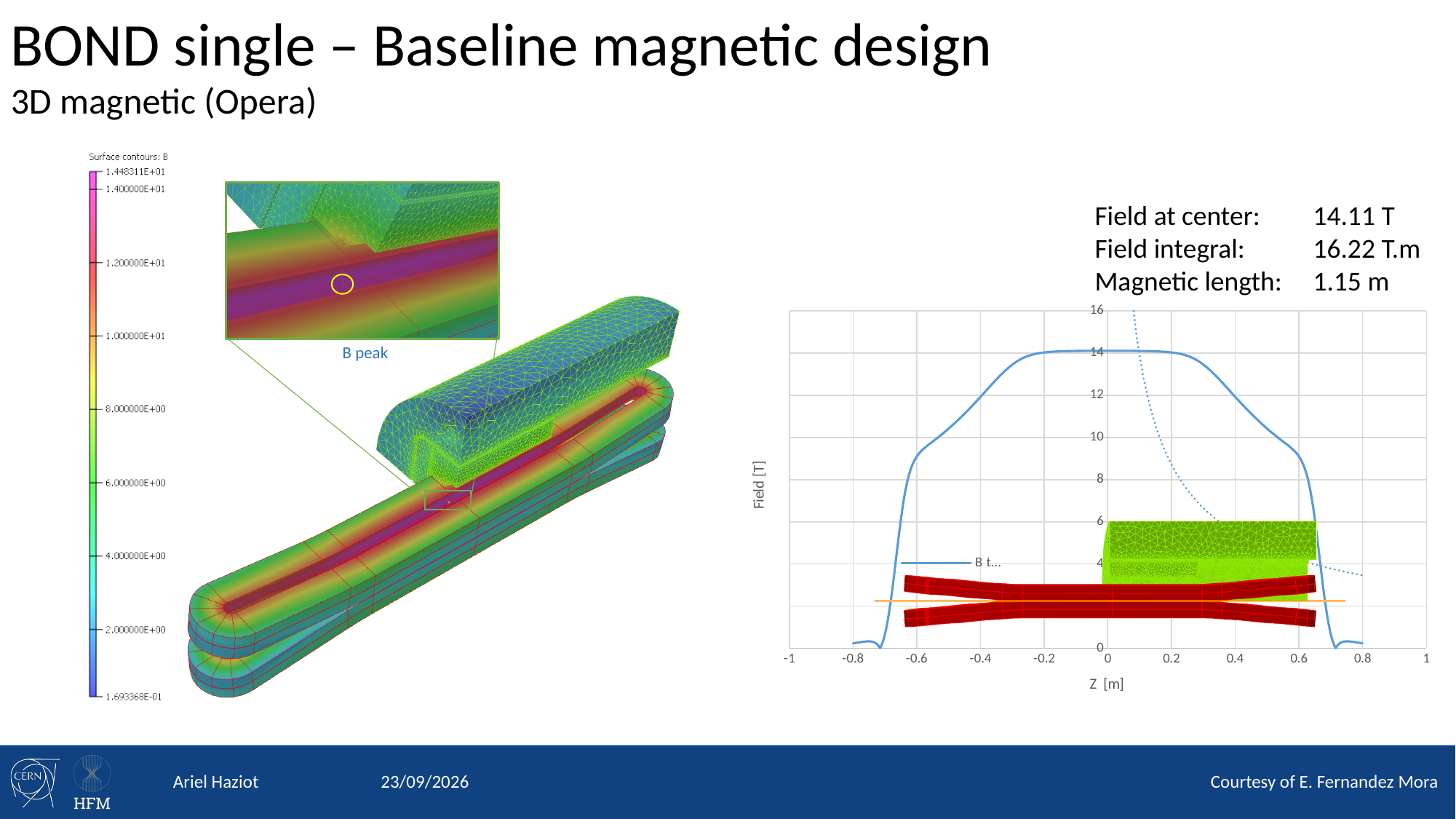
In the Field [T] vs Z [m] chart, does the solid-line field rise or fall as Z goes from 0 to 0.8? fall In the Field [T] vs Z [m] chart, what is the label of the y axis? Field [T] In the Field [T] vs Z [m] chart, is the solid-line field value at Z = 0.2 greater or less than 12? greater In the Field [T] vs Z [m] chart, is the solid-line field value at Z = 0 greater or less than 12? greater According to the text above the chart, what is the field at center? 14.11 T According to the text above the chart, what is the field integral? 16.22 T.m In the Field [T] vs Z [m] chart, what is the label of the x axis? Z [m] In the Field [T] vs Z [m] chart, does the solid-line field rise or fall as Z goes from -0.8 to 0? rise In the Field [T] vs Z [m] chart, which has the larger solid-line field value: Z = -0.6 or Z = -0.8? Z = -0.6 In the Field [T] vs Z [m] chart, is the solid-line field value at Z = -0.8 greater or less than 2? less What kind of chart is shown on the right of the slide, plotting Field [T] against Z [m]? line chart According to the text above the chart, what is the magnetic length? 1.15 m